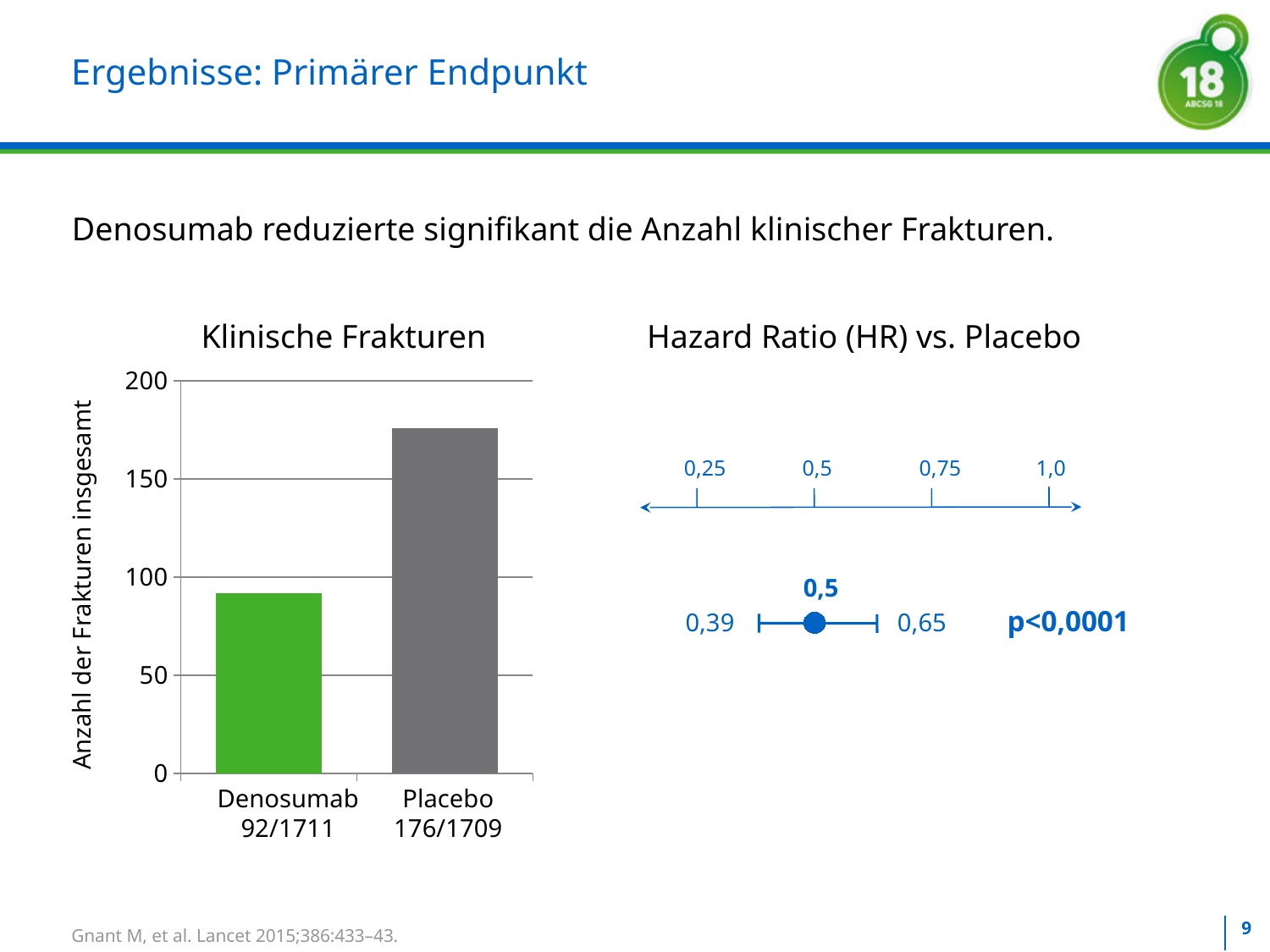
In the 'Klinische Frakturen' chart, which category has the lower number of fractures? Denosumab In the 'Klinische Frakturen' chart, what is the difference in the number of fractures between Placebo and Denosumab? 84 In the 'Klinische Frakturen' chart, how many categories are plotted? 2 In the 'Hazard Ratio (HR) vs. Placebo' chart, what is the hazard ratio point estimate? 0,5 In the 'Klinische Frakturen' chart, how many fractures are shown for Denosumab according to the category label? 92 In the 'Klinische Frakturen' chart, what is the y-axis label? Anzahl der Frakturen insgesamt In the 'Klinische Frakturen' chart, is the value for Denosumab greater or less than 100? less In the 'Hazard Ratio (HR) vs. Placebo' chart, what are the lower and upper bounds of the confidence interval? 0,39 and 0,65 In the 'Klinische Frakturen' chart, how many fractures are shown for Placebo according to the category label? 176 In the 'Klinische Frakturen' chart, what type of chart is shown? bar chart In the 'Klinische Frakturen' chart, which category has the higher number of fractures? Placebo In the 'Klinische Frakturen' chart, is the value for Placebo greater or less than 150? greater